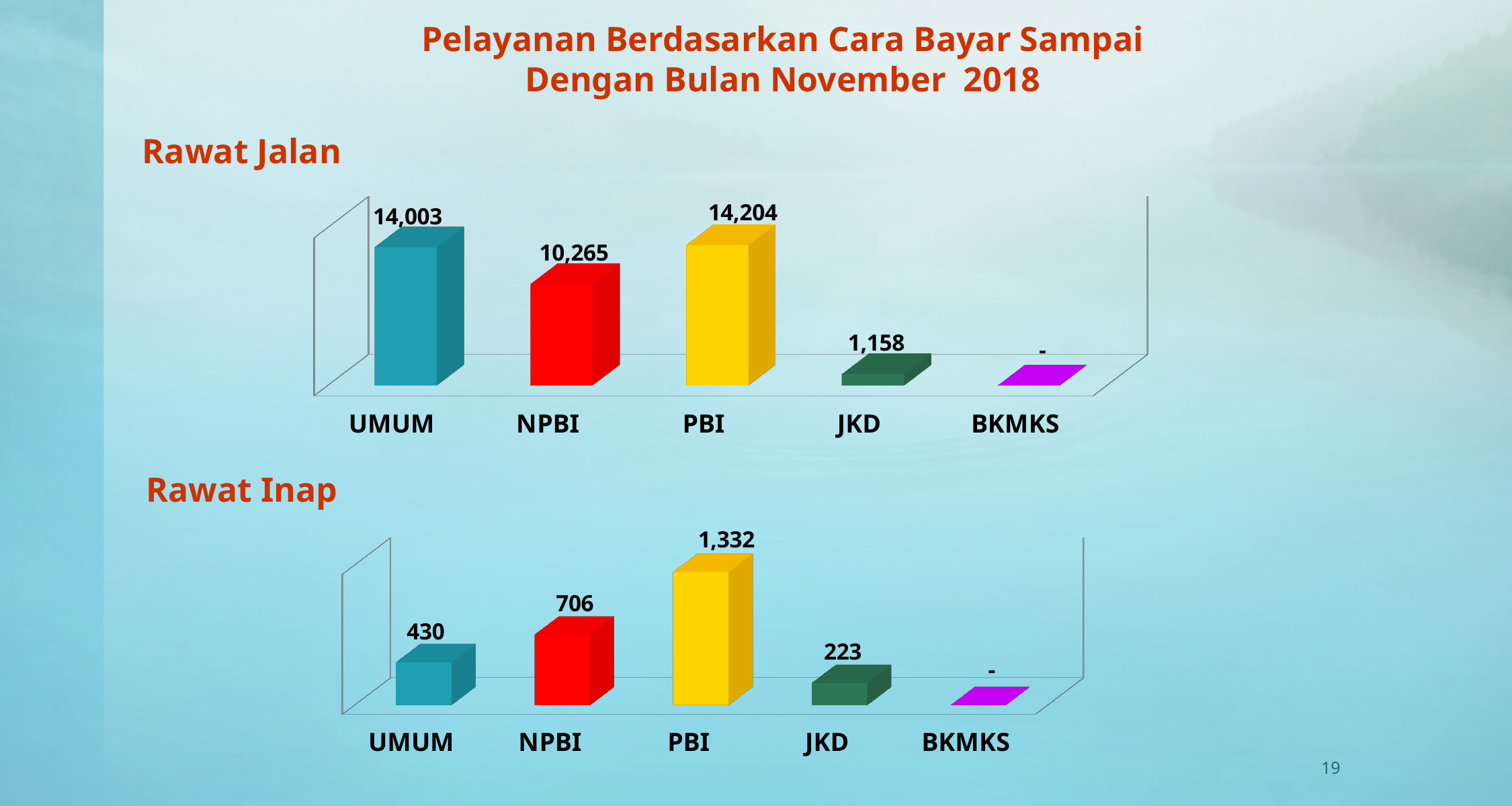
In the Rawat Jalan chart, what is the difference between the values for PBI and UMUM? 201 In the Rawat Inap chart, which category has the highest value? PBI In the Rawat Jalan chart, which category has the highest value? PBI In the Rawat Jalan chart, what colour is the PBI bar? Yellow In the Rawat Inap chart, what is the value for JKD? 223 In the Rawat Inap chart, which is larger, the value for UMUM or the value for NPBI? NPBI In the Rawat Jalan chart, what is the value for UMUM? 14,003 How many categories are shown on the x axis of the Rawat Jalan chart? 5 In the Rawat Inap chart, what is the value for PBI? 1,332 What kind of chart is the Rawat Inap chart? Bar chart In the Rawat Inap chart, what is the difference between the values for PBI and NPBI? 626 In the Rawat Jalan chart, what is the value for NPBI? 10,265